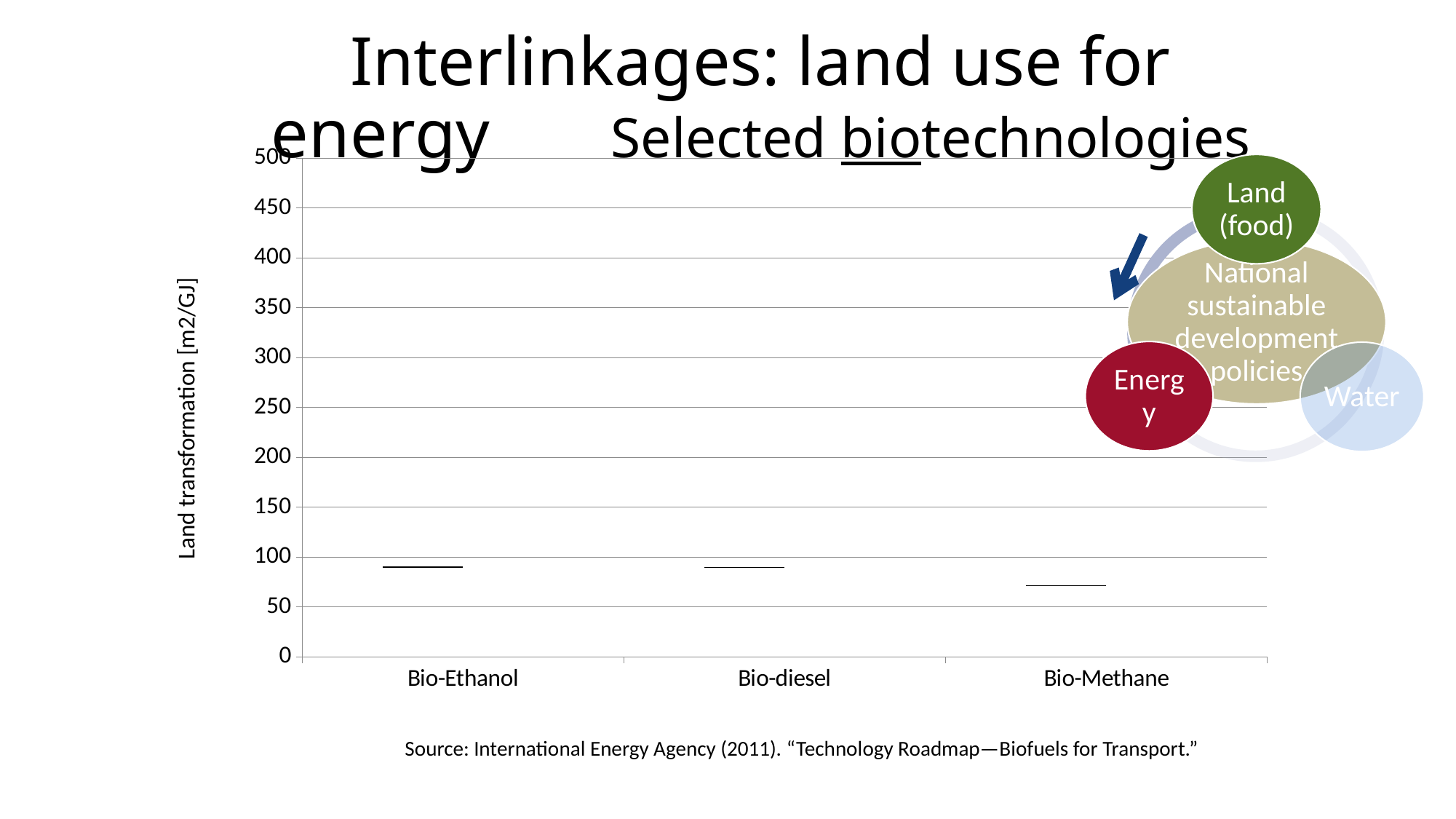
Is the value for Bio-Ethanol greater or less than 100? less Which category has the lowest land transformation value in the chart? Bio-Methane Which has the larger value, Bio-Ethanol or Bio-Methane? Bio-Ethanol Is the value for Bio-Ethanol greater or less than 50? greater Is the value for Bio-Methane greater or less than 50? greater How many categories are shown on the x axis of the chart? 3 What is the label of the chart's vertical axis? Land transformation [m2/GJ] Which has the larger value, Bio-diesel or Bio-Methane? Bio-diesel Do the values rise or fall moving from Bio-Ethanol to Bio-Methane along the x axis? fall What is the title of the chart? Selected biotechnologies